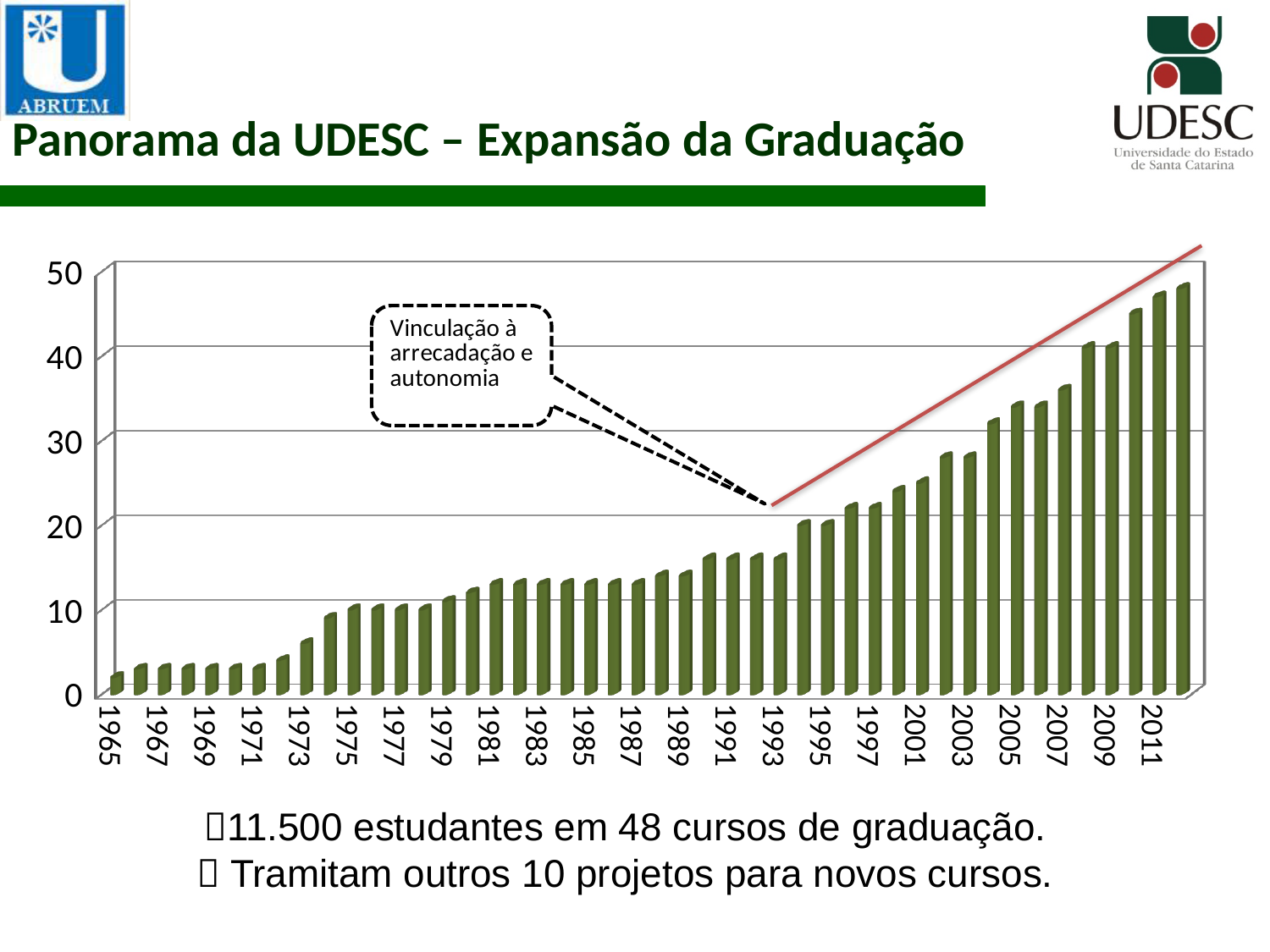
Is the value for 1981 greater or less than 10? greater Do the values generally rise or fall from 1965 to 2011? rise What is the highest value shown on the vertical axis? 50 What text is written in the dashed callout box on the chart? Vinculação à arrecadação e autonomia Is the value for 1973 greater or less than 10? less What kind of chart is shown on the slide? bar chart Is the value for 1965 greater or less than 10? less Which year has the larger value, 1973 or 1983? 1983 Which year has the larger value, 1965 or 2011? 2011